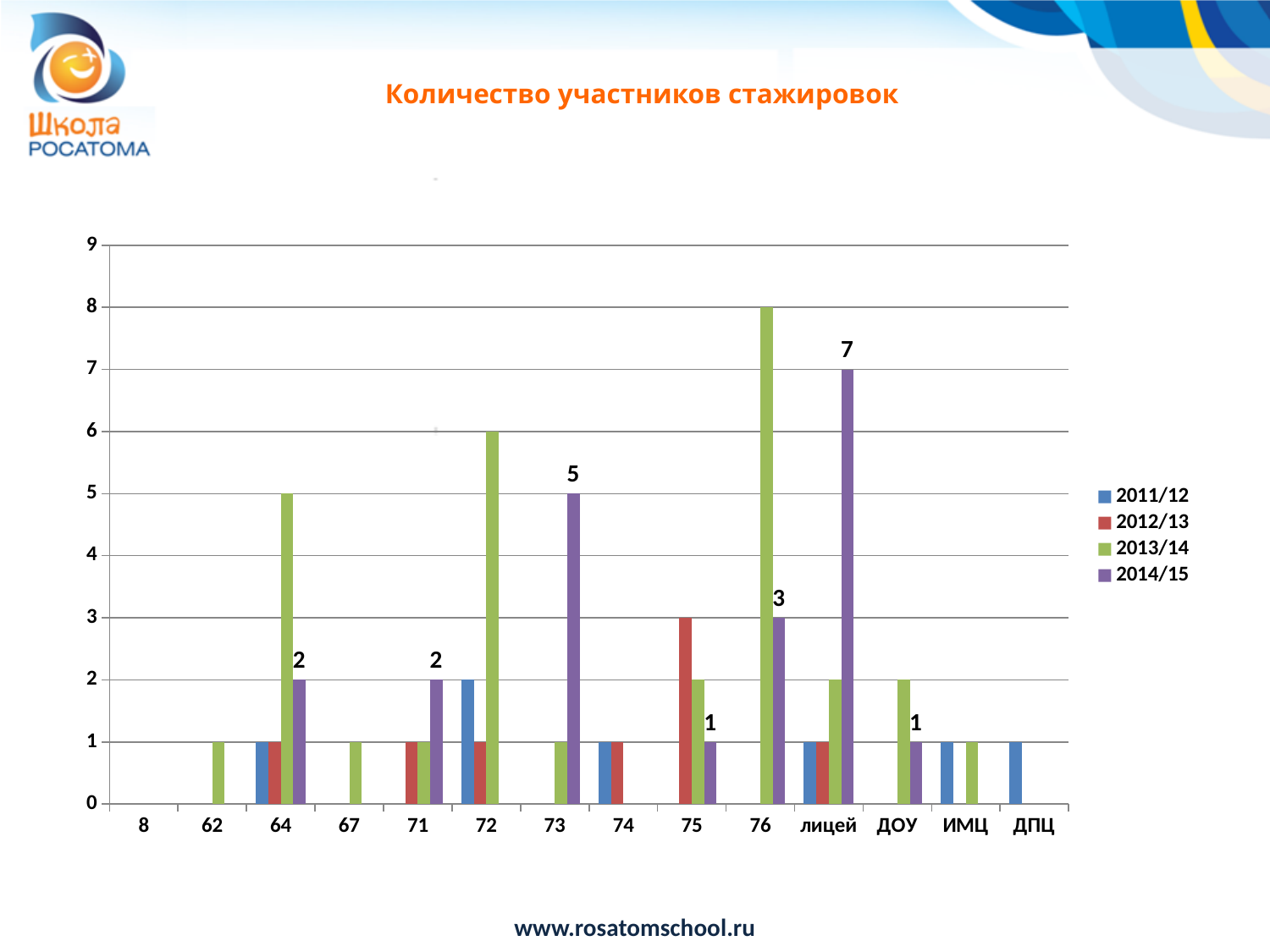
What is the title of the chart? Количество участников стажировок What is the value for 2014/15 in category лицей? 7 Which is larger: the 2014/15 value for 64 or the 2014/15 value for 76? 76 How many categories are shown on the x axis? 14 What is the value for 2014/15 in category 76? 3 What kind of chart is shown on the slide? bar chart What is the value for 2013/14 in category 76? 8 What is the value for 2014/15 in category 73? 5 How many series does the legend list? 4 What is the difference between the 2014/15 values for лицей and 73? 2 Is the 2013/14 value for category 72 greater or less than 4? greater Which category has the highest value for the 2014/15 series? лицей